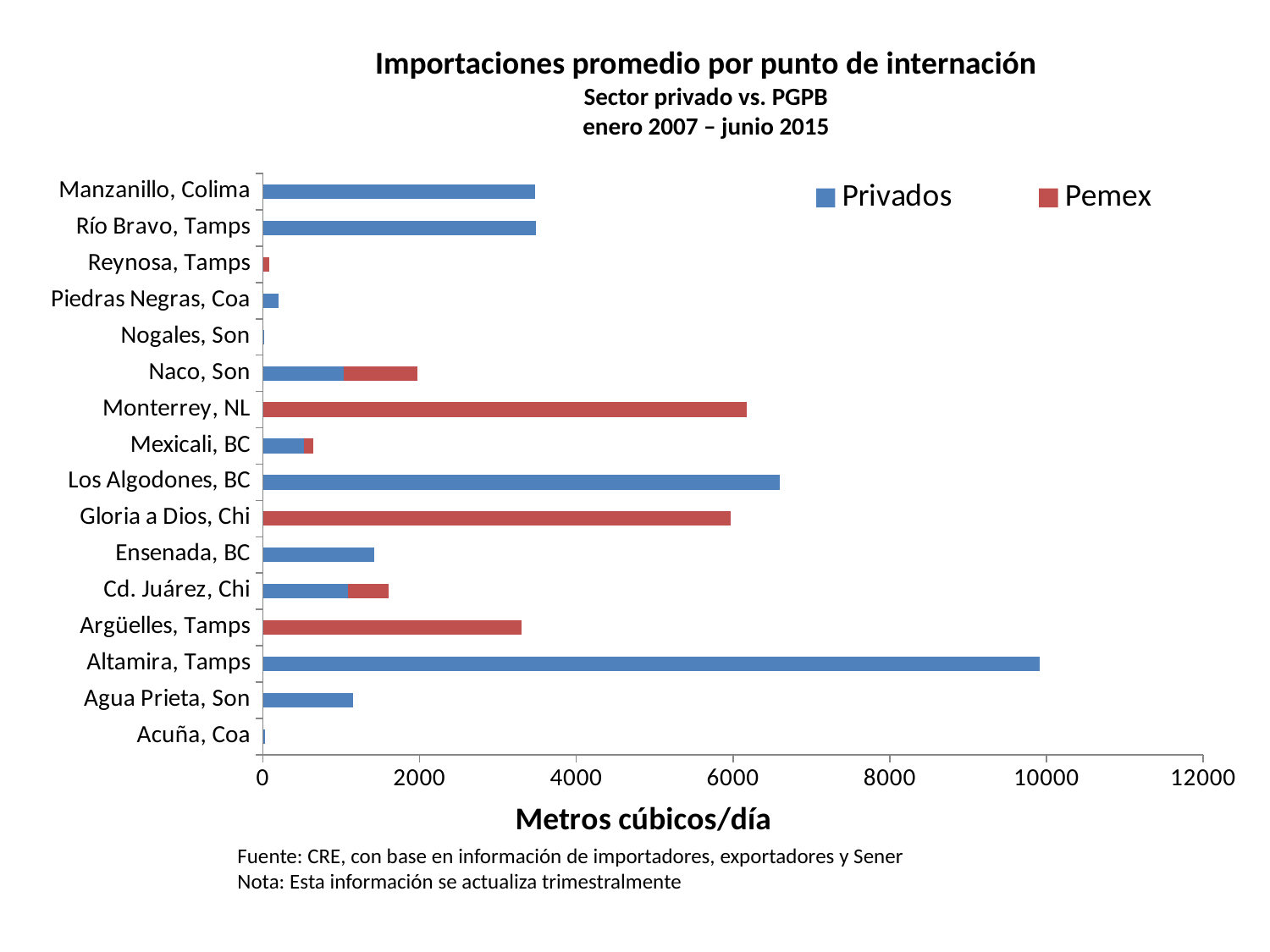
Is the total value for Altamira, Tamps greater or less than 8000? greater Which has the larger total bar, Monterrey, NL or Argüelles, Tamps? Monterrey, NL Is the value for Ensenada, BC greater or less than 2000? less How many points of entry (categories) are shown on the y axis? 16 Is the value for Manzanillo, Colima greater or less than 4000? less Which point of entry has the longest total bar? Altamira, Tamps What kind of chart is shown on the slide? bar chart Which has the larger bar, Ensenada, BC or Agua Prieta, Son? Ensenada, BC What colour represents the Pemex series in the legend? red How many series does the legend list? 2